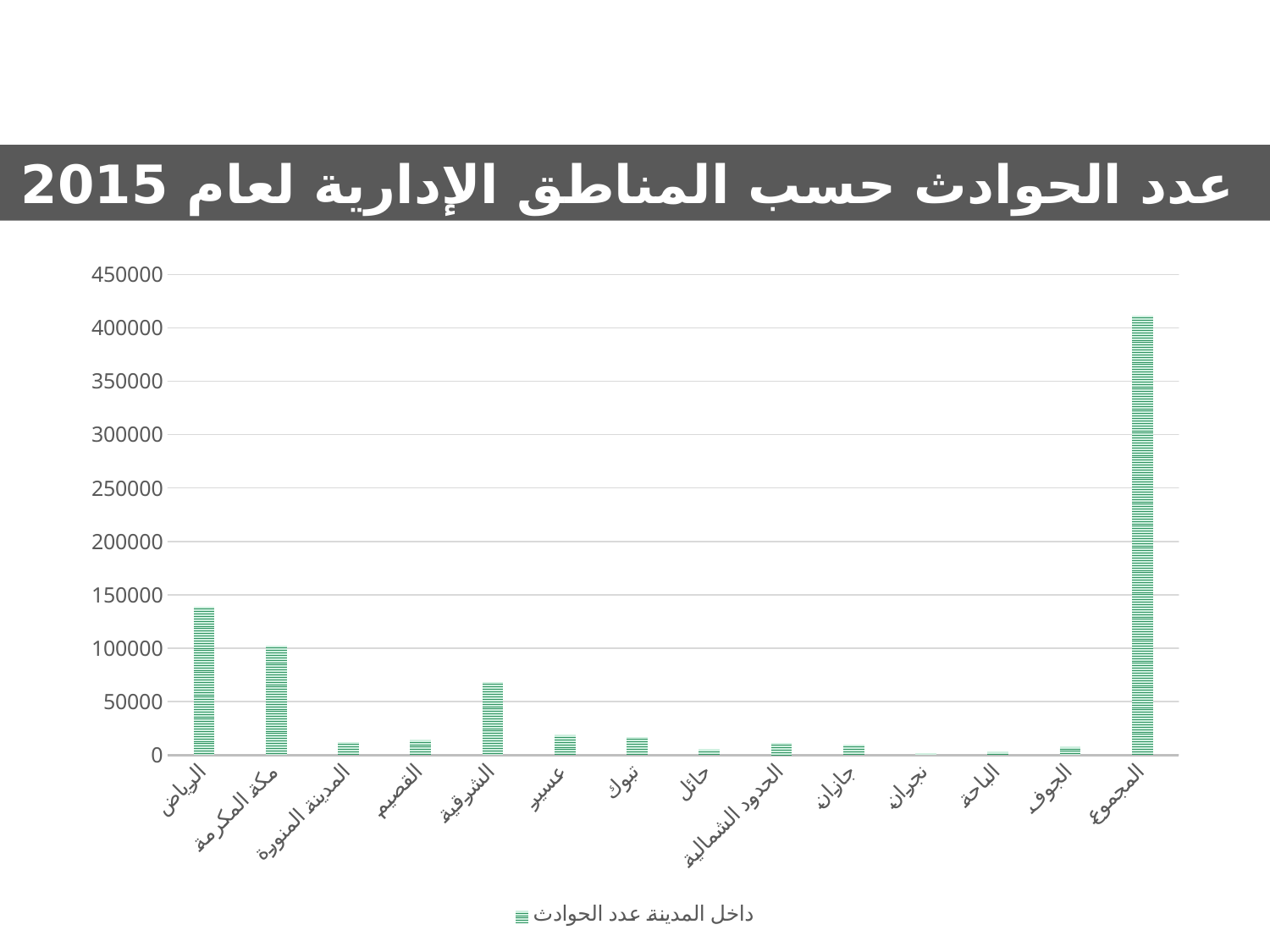
Is the value for الشرقية greater or less than 50000? greater Is the value for المجموع greater or less than 400000? greater Is the value for الرياض greater or less than 100000? greater What kind of chart is shown on the slide? bar chart How many series does the legend list? 1 Excluding المجموع, which region has the highest number of accidents? الرياض How many categories are shown on the x axis of the chart? 14 Which is larger, the value for الرياض or the value for مكة المكرمة? الرياض Which category has the tallest bar in the chart? المجموع Which is larger, the value for الشرقية or the value for عسير? الشرقية